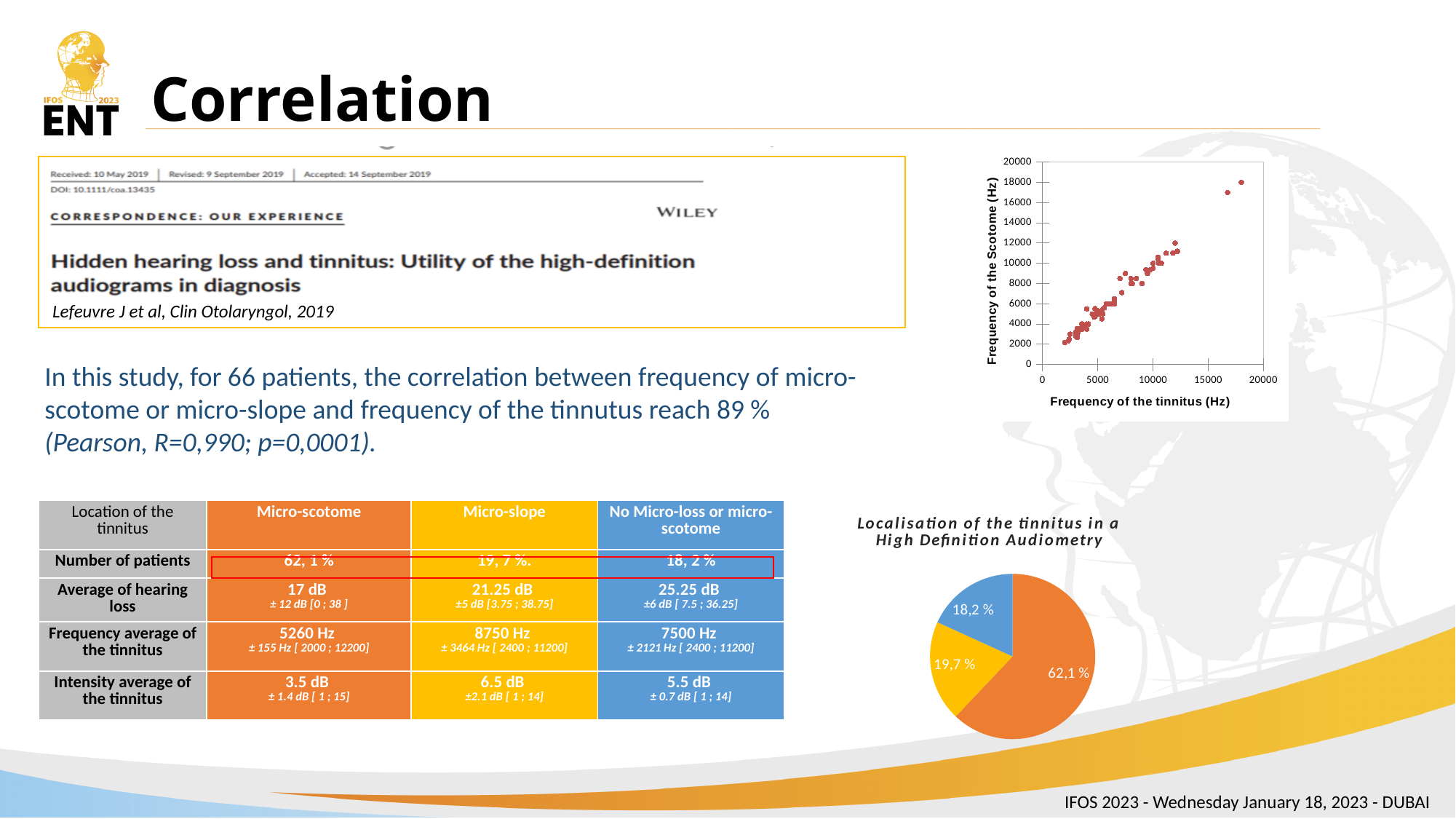
In the scatter plot, what is the label of the y axis? Frequency of the Scotome (Hz) In the scatter plot, are the points with tinnitus frequency below 5000 Hz at a scotome frequency greater or less than 8000? less In the scatter plot, what is the highest tick value shown on the y axis? 20000 In the scatter plot, do the values of Frequency of the Scotome rise or fall as Frequency of the tinnitus increases? rise What kind of chart is the chart titled 'Localisation of the tinnitus in a High Definition Audiometry'? pie chart How many slices does the pie chart 'Localisation of the tinnitus in a High Definition Audiometry' have? 3 In the pie chart 'Localisation of the tinnitus in a High Definition Audiometry', what is the share of the smallest slice? 18,2 % In the scatter plot, what is the label of the x axis? Frequency of the tinnitus (Hz) In the pie chart 'Localisation of the tinnitus in a High Definition Audiometry', what is the share of the largest slice? 62,1 % In the pie chart 'Localisation of the tinnitus in a High Definition Audiometry', what is the share of the yellow slice? 19,7 % In the scatter plot, is the Frequency of the Scotome for the highest point greater or less than 16000? greater What kind of chart is the chart in the top right of the slide? scatter plot